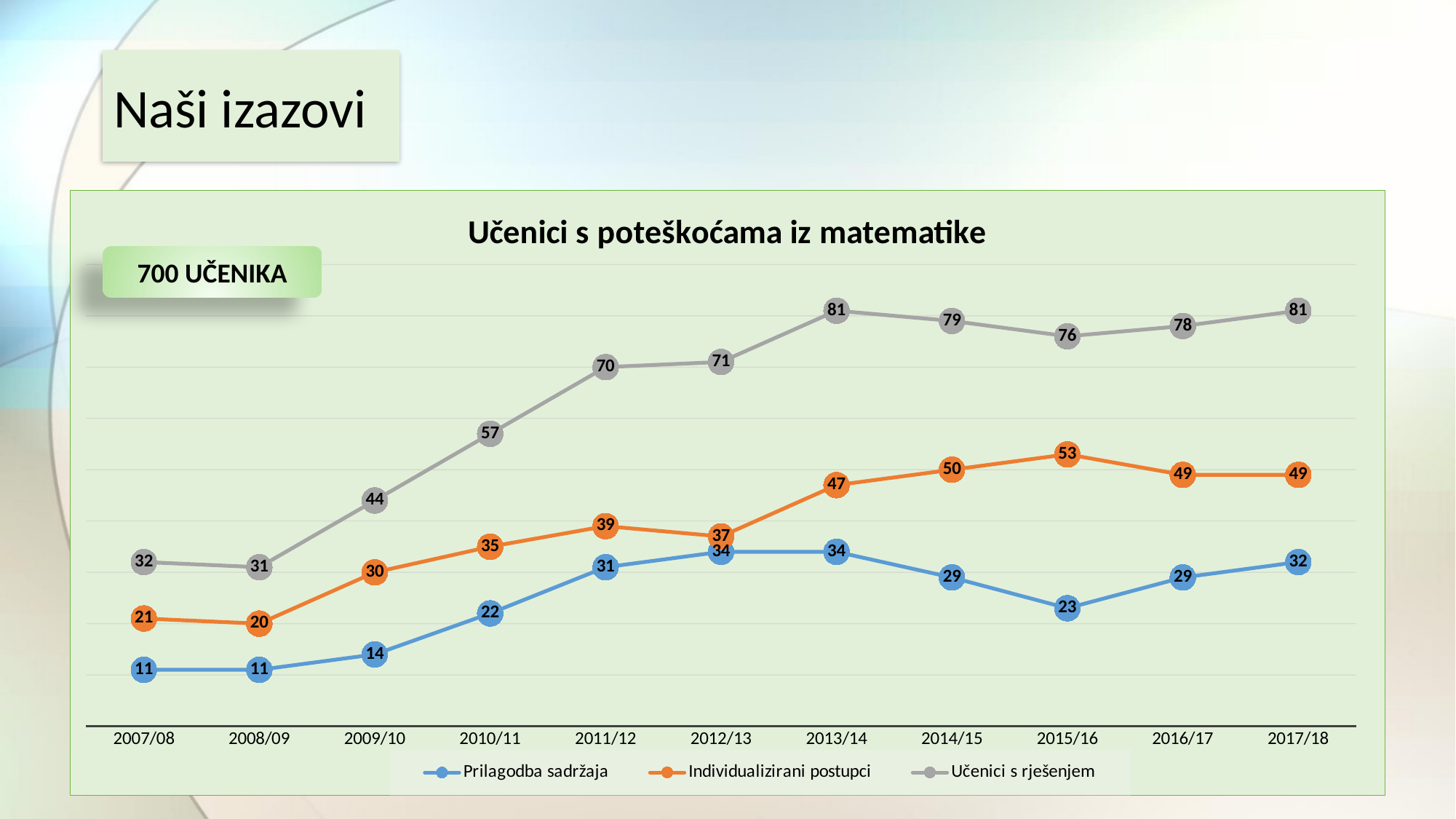
What is the difference between Učenici s rješenjem and Prilagodba sadržaja in 2017/18? 49 In which school year is the value for Učenici s rješenjem lowest? 2008/09 What is the title of the chart? Učenici s poteškoćama iz matematike In which school year is the value for Individualizirani postupci highest? 2015/16 What kind of chart is shown on the slide? Line chart What is the value for Učenici s rješenjem in 2013/14? 81 How many school years are shown on the x axis? 11 What is the value for Individualizirani postupci in 2011/12? 39 How many series does the legend list? 3 What is the value for Prilagodba sadržaja in 2015/16? 23 Does the value for Učenici s rješenjem rise or fall from 2007/08 to 2013/14? Rise Which series has the larger value in 2009/10, Prilagodba sadržaja or Individualizirani postupci? Individualizirani postupci